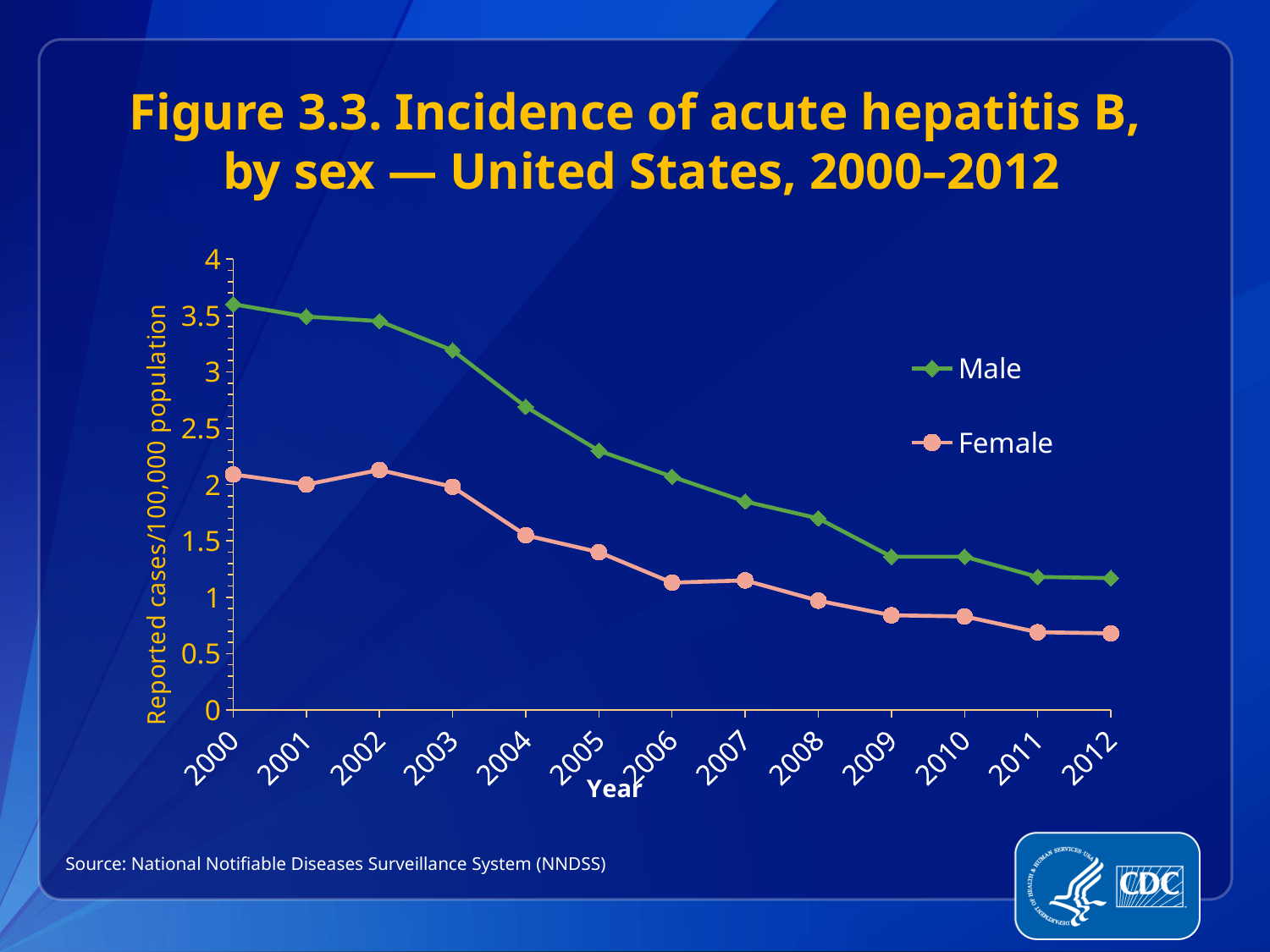
How many series does the legend list? 2 Is the Female value for 2012 greater or less than 1? less In which year is the Male incidence highest? 2000 Is the Male value for 2000 greater or less than 3? greater Is the Male value for 2004 greater or less than 2.5? greater What is the label of the y axis? Reported cases/100,000 population How many years are plotted along the x axis? 13 Do the Male values rise or fall from 2000 to 2012? fall What kind of chart is shown on the slide? line chart Which series has the larger value in 2005, Male or Female? Male